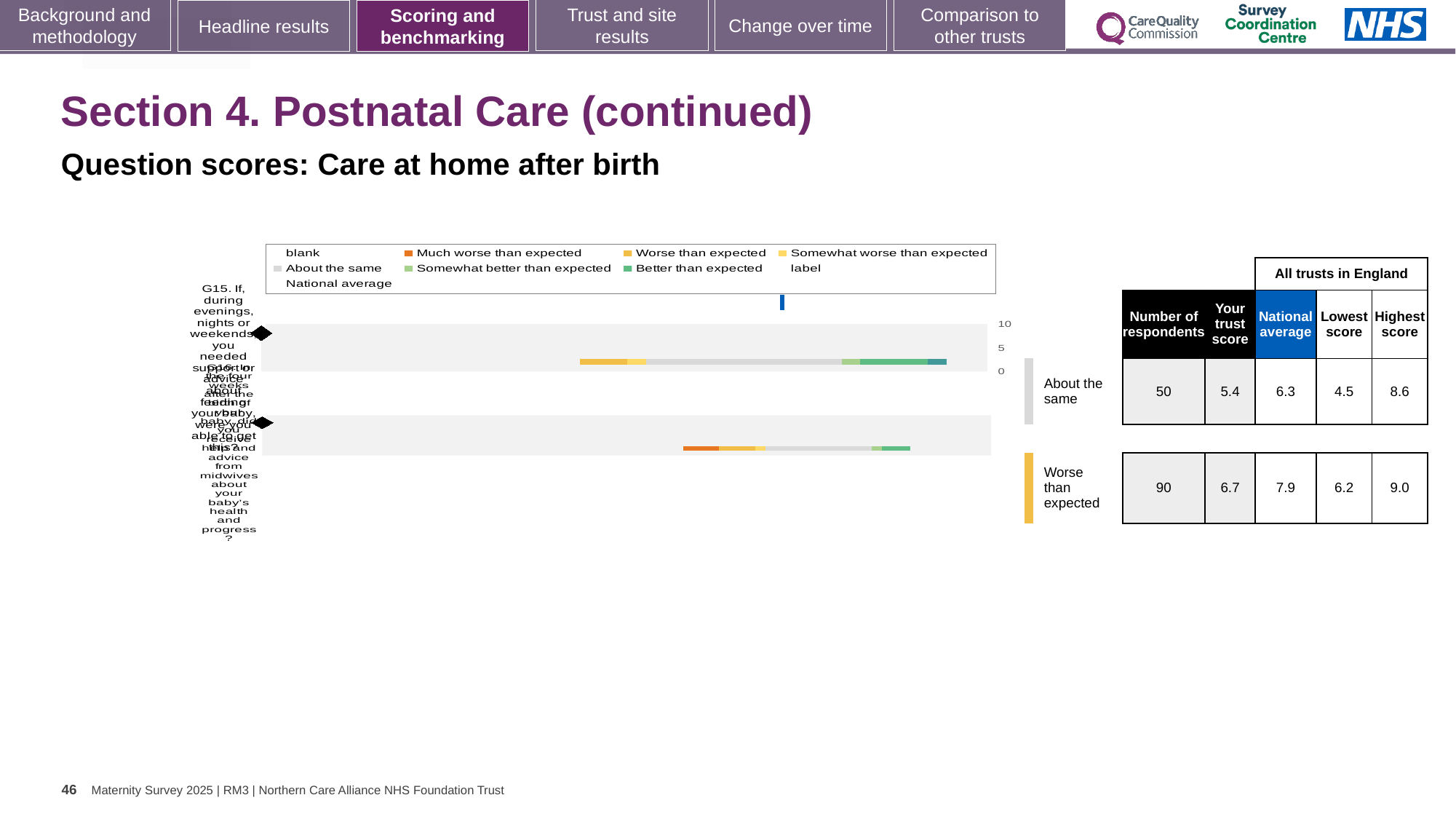
What benchmark category is shown for the first question (G15, top bar)? About the same How many questions (bars) are plotted in the chart? 2 Which question has the higher trust score, G15 (top bar) or G16 (bottom bar)? G16 In the table beside the chart, what is the lowest score for the first question (G15, top bar)? 4.5 What is the difference between the national average and the trust score for the second question (G16, bottom bar)? 1.2 Which question has the larger number of respondents, G15 (top bar) or G16 (bottom bar)? G16 In the table beside the chart, what is the national average for the first question (G15, top bar)? 6.3 In the table beside the chart, what is the number of respondents for the first question (G15, top bar)? 50 What type of chart is shown on the slide? bar chart In the table beside the chart, what is the highest score for the second question (G16, bottom bar)? 9.0 How many entries does the chart legend list? 9 In the table beside the chart, what is the trust score for the second question (G16, bottom bar)? 6.7